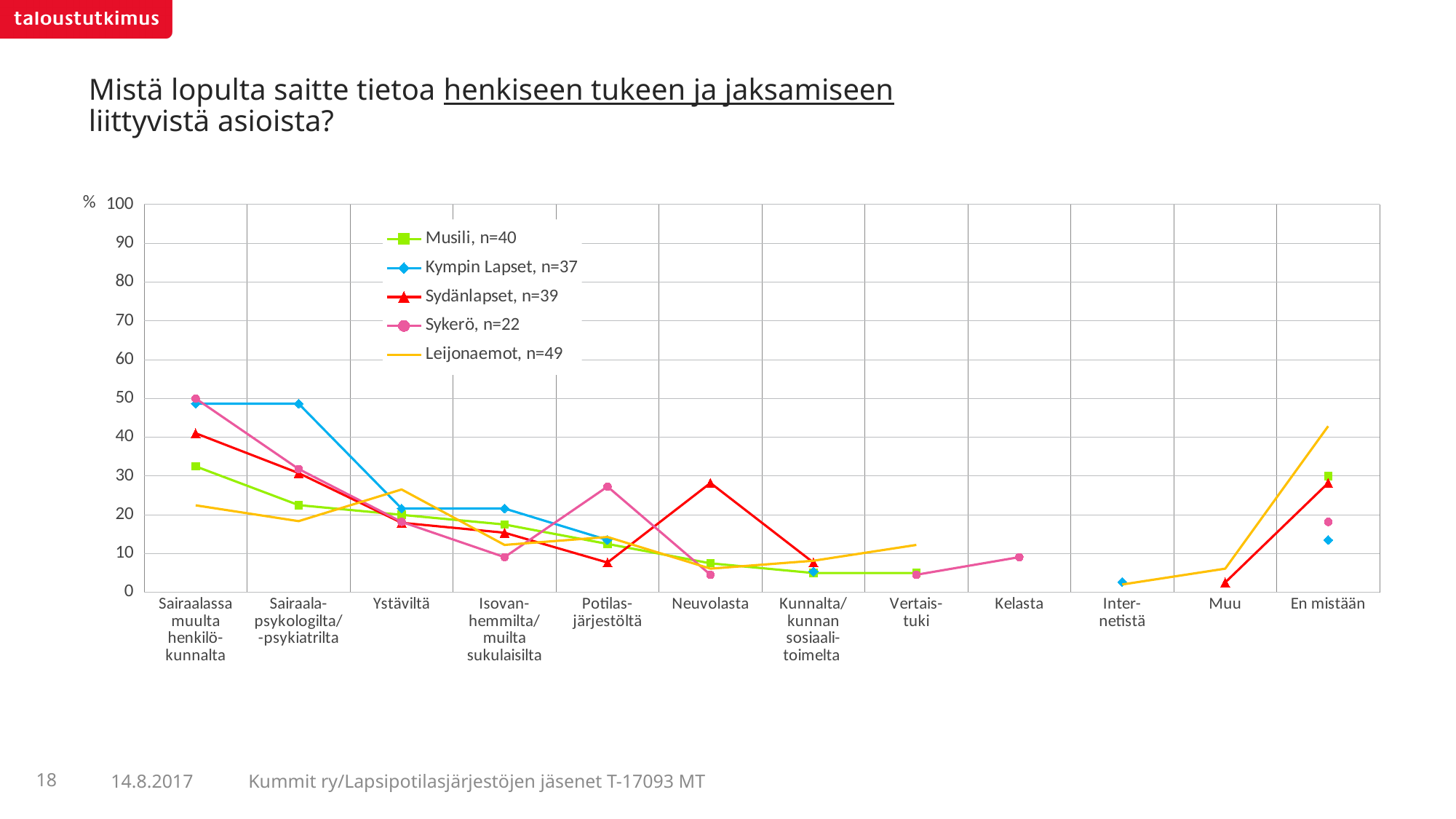
Is the value for Sydänlapset at 'Neuvolasta' greater or less than 20? greater Which series has the highest value at 'Sairaala-psykologilta/-psykiatrilta'? Kympin Lapset, n=37 How many series does the legend list? 5 Is the value for Leijonaemot at 'En mistään' greater or less than 40? greater Does the Kympin Lapset line rise or fall from 'Sairaala-psykologilta/-psykiatrilta' to 'Ystäviltä'? fall What sample size (n) does the legend give for Leijonaemot? n=49 Which series has the highest value at 'Neuvolasta'? Sydänlapset, n=39 What kind of chart is shown on the slide? line chart Is the value for Sykerö at 'Potilasjärjestöltä' greater or less than 20? greater How many categories are shown along the x axis? 12 Which series has the highest value at 'En mistään'? Leijonaemot, n=49 At 'Sairaala-psykologilta/-psykiatrilta', which is larger: Kympin Lapset or Leijonaemot? Kympin Lapset